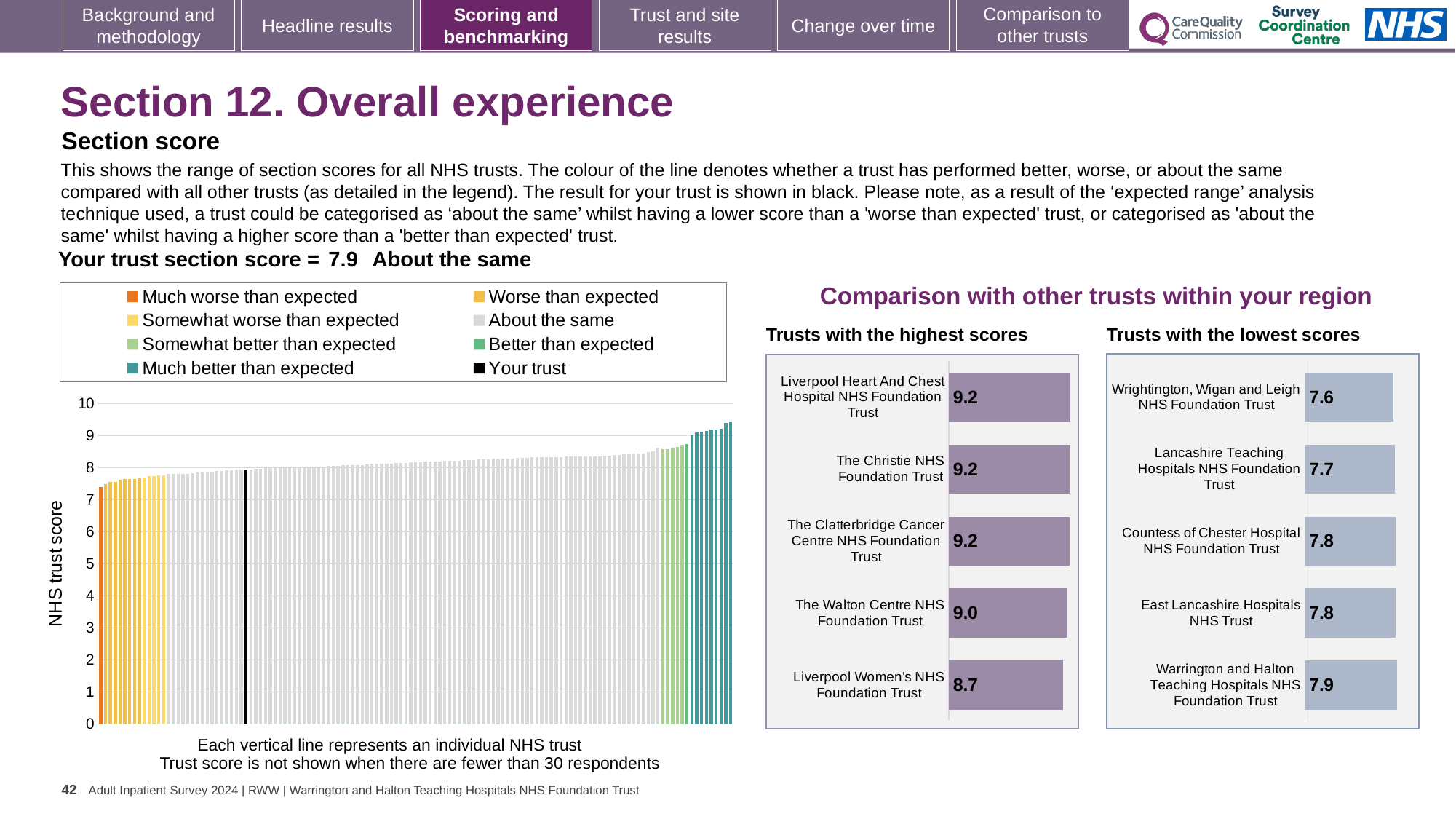
In the 'Trusts with the highest scores' chart, what is the score for The Walton Centre NHS Foundation Trust? 9.0 In the 'Trusts with the lowest scores' chart, which trust has the lowest score? Wrightington, Wigan and Leigh NHS Foundation Trust In the 'Trusts with the highest scores' chart, what is the score for Liverpool Women's NHS Foundation Trust? 8.7 In the 'Trusts with the highest scores' chart, which trust has the lowest score? Liverpool Women's NHS Foundation Trust In the 'Trusts with the lowest scores' chart, what is the score for Countess of Chester Hospital NHS Foundation Trust? 7.8 How many trusts are shown in the 'Trusts with the lowest scores' chart? 5 In the 'Trusts with the highest scores' chart, what is the difference between the scores of Liverpool Heart And Chest Hospital NHS Foundation Trust and Liverpool Women's NHS Foundation Trust? 0.5 In the 'Trusts with the highest scores' chart, which has the higher score: The Walton Centre NHS Foundation Trust or Liverpool Women's NHS Foundation Trust? The Walton Centre NHS Foundation Trust In the 'Trusts with the lowest scores' chart, what is the difference between the scores of Warrington and Halton Teaching Hospitals NHS Foundation Trust and Wrightington, Wigan and Leigh NHS Foundation Trust? 0.3 In the 'Trusts with the lowest scores' chart, which trust has the highest score? Warrington and Halton Teaching Hospitals NHS Foundation Trust How many entries does the legend of the 'NHS trust score' chart list? 8 In the 'NHS trust score' chart, is the value of the tallest bar greater or less than 9? greater